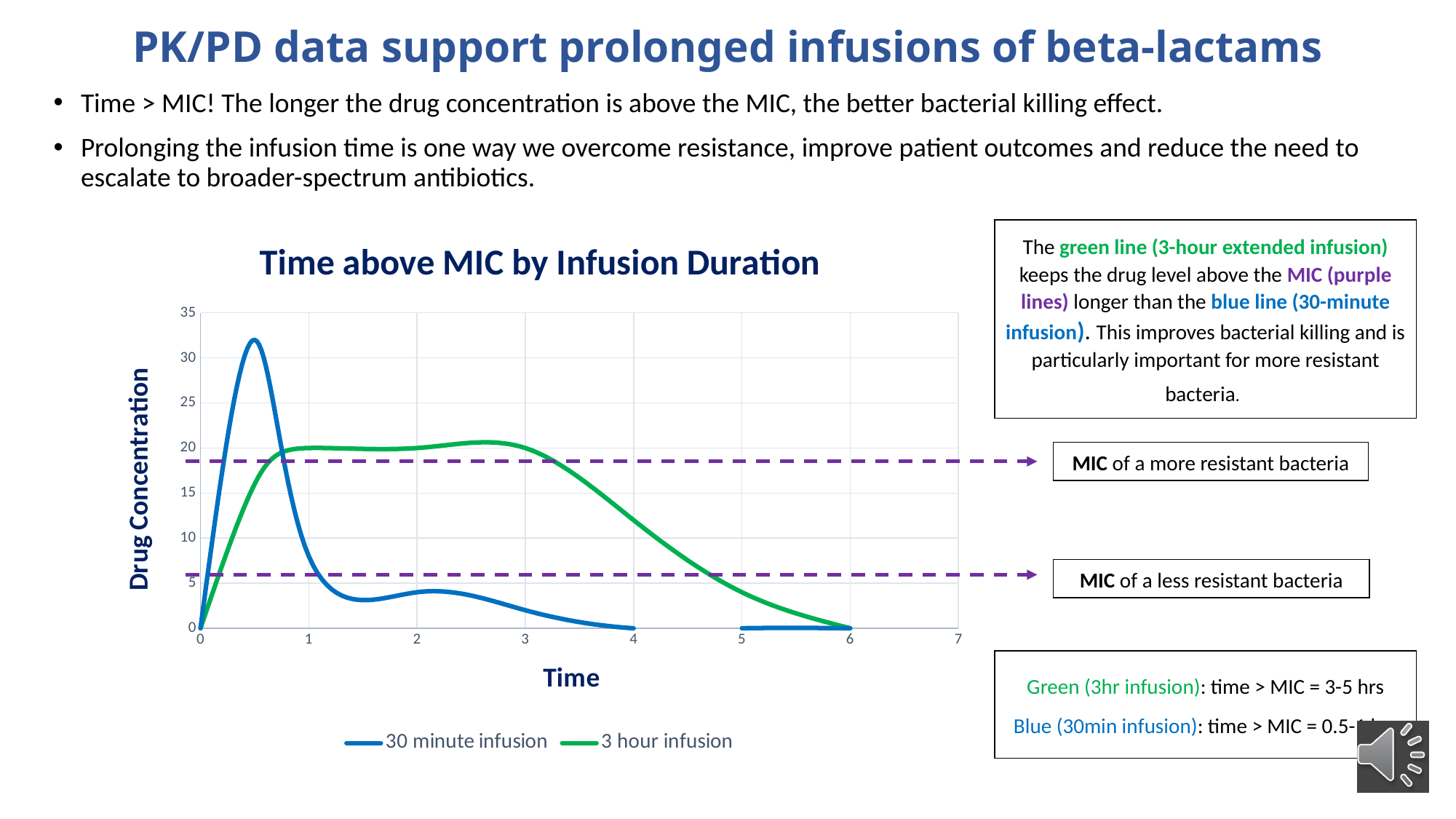
What is the title of the chart? Time above MIC by Infusion Duration Which series reaches the higher peak drug concentration, 30 minute infusion or 3 hour infusion? 30 minute infusion Is the peak value of the 3 hour infusion line greater or less than 25? less How many series does the chart legend list? 2 Which series stays above zero drug concentration for longer, 30 minute infusion or 3 hour infusion? 3 hour infusion Is the peak value of the 30 minute infusion line greater or less than 30? greater What is the highest value shown on the y axis of the chart? 35 What are the two series named in the chart legend? 30 minute infusion and 3 hour infusion Is the value of the 3 hour infusion line at time 2 greater or less than 15? greater What kind of chart is shown on the slide? line chart Does the 30 minute infusion line rise or fall between time 1 and time 4? fall